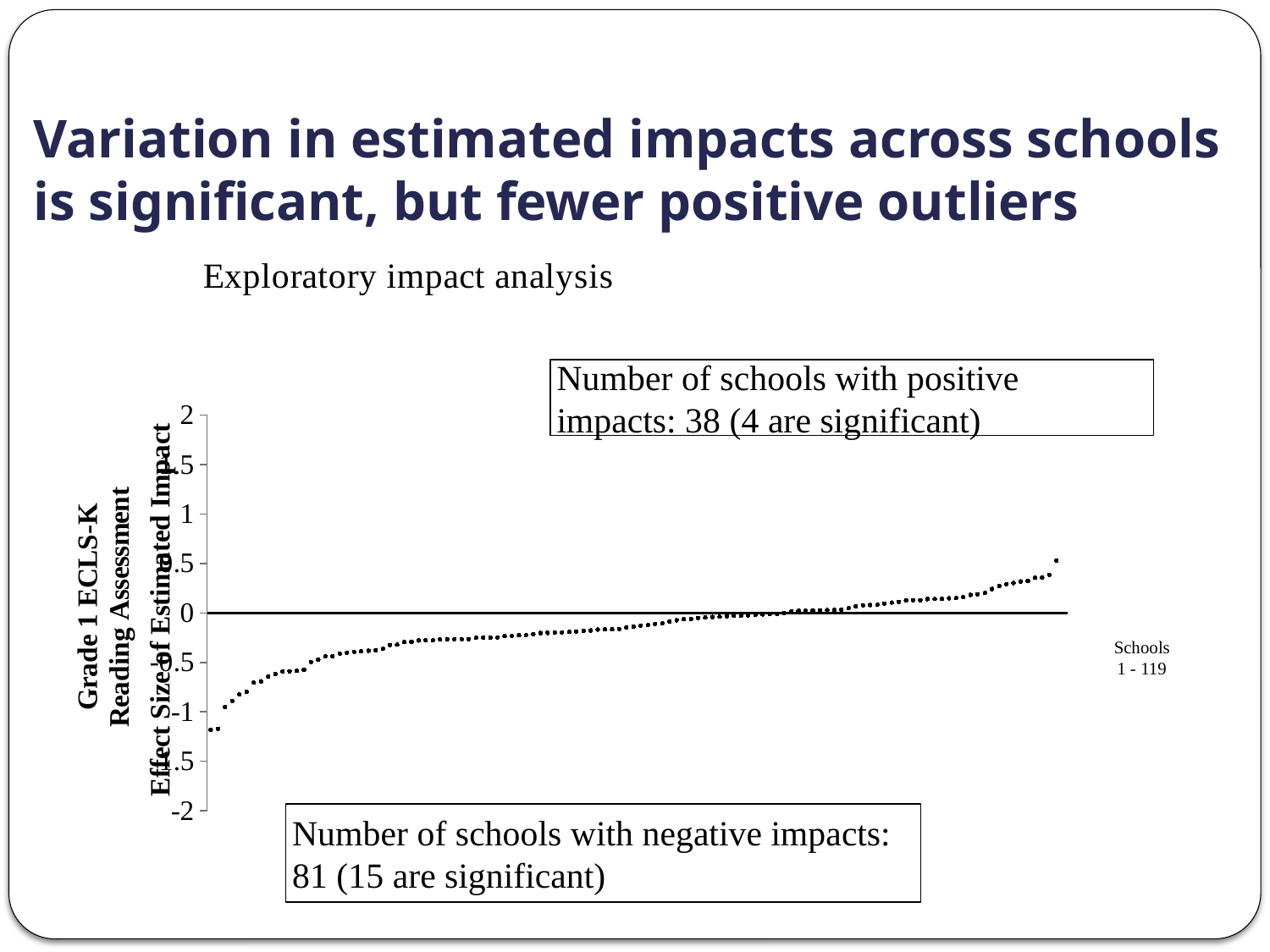
How many of the schools with negative impacts are significant, according to the annotation? 15 Is the lowest plotted effect size greater or less than -1? less What kind of chart is shown on the slide? Scatter (dot) chart Do the plotted effect sizes rise or fall moving from left to right along the x axis? Rise According to the annotation on the chart, how many schools have negative impacts? 81 What is the label on the y axis of the chart? Effect Size of Estimated Impact Is the highest plotted effect size greater or less than 0? greater How many schools are plotted in the chart, according to the x-axis label? 119 Is the highest plotted effect size greater or less than 1? less What is the subtitle shown above the chart? Exploratory impact analysis